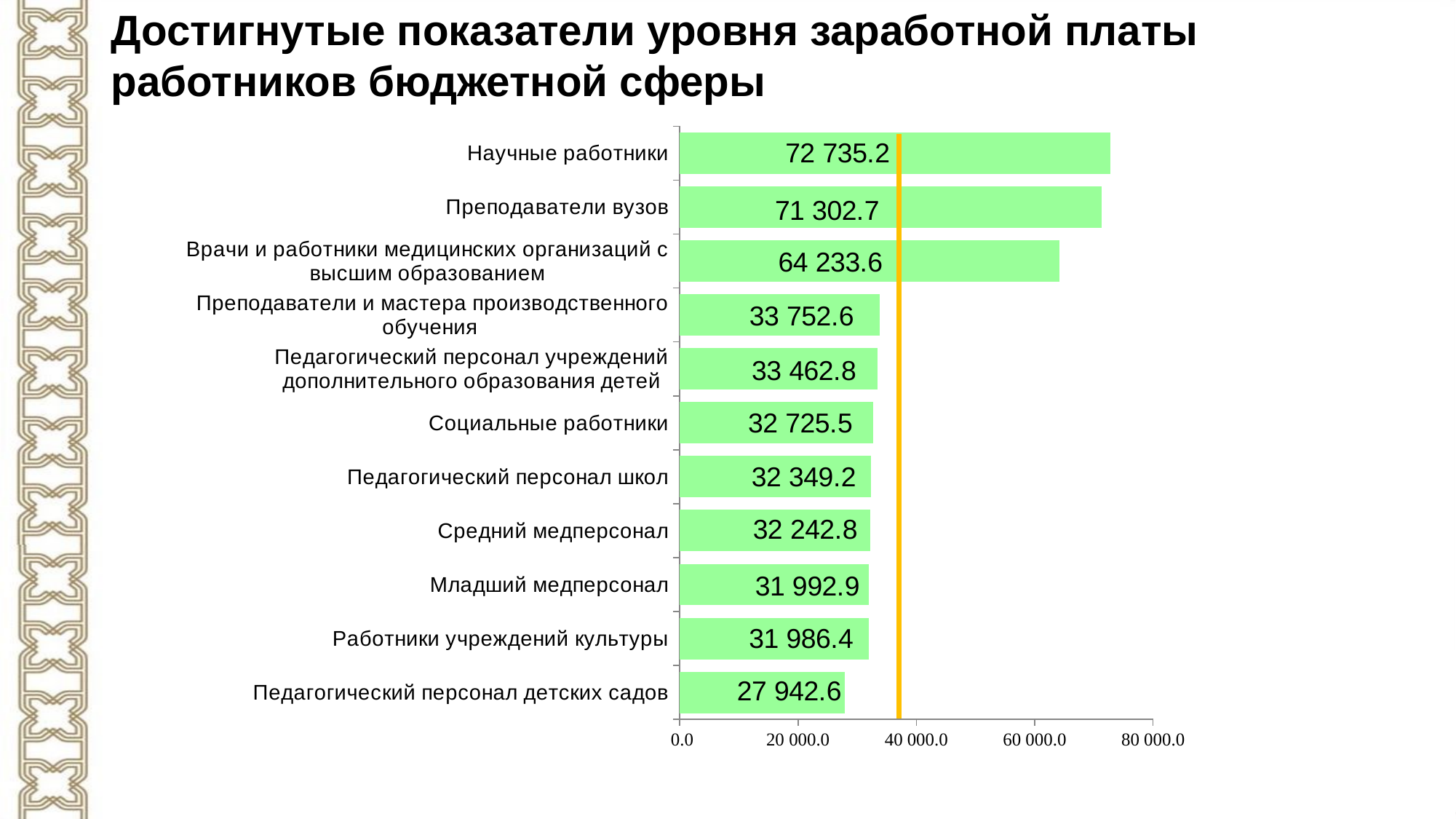
What is the value for Средний медперсонал? 32 242.8 Which category has the highest value? Научные работники What is the value for Врачи и работники медицинских организаций с высшим образованием? 64 233.6 Which is larger, the value for Социальные работники or the value for Педагогический персонал школ? Социальные работники What is the difference between the values for Преподаватели и мастера производственного обучения and Педагогический персонал детских садов? 5 810.0 Is the value for Врачи и работники медицинских организаций с высшим образованием greater or less than 60 000.0? greater What kind of chart is shown on the slide? bar chart How many categories are shown in the chart? 11 What is the difference between the values for Научные работники and Преподаватели вузов? 1 432.5 Which category has the lowest value? Педагогический персонал детских садов What is the value for Научные работники? 72 735.2 What is the value for Педагогический персонал детских садов? 27 942.6